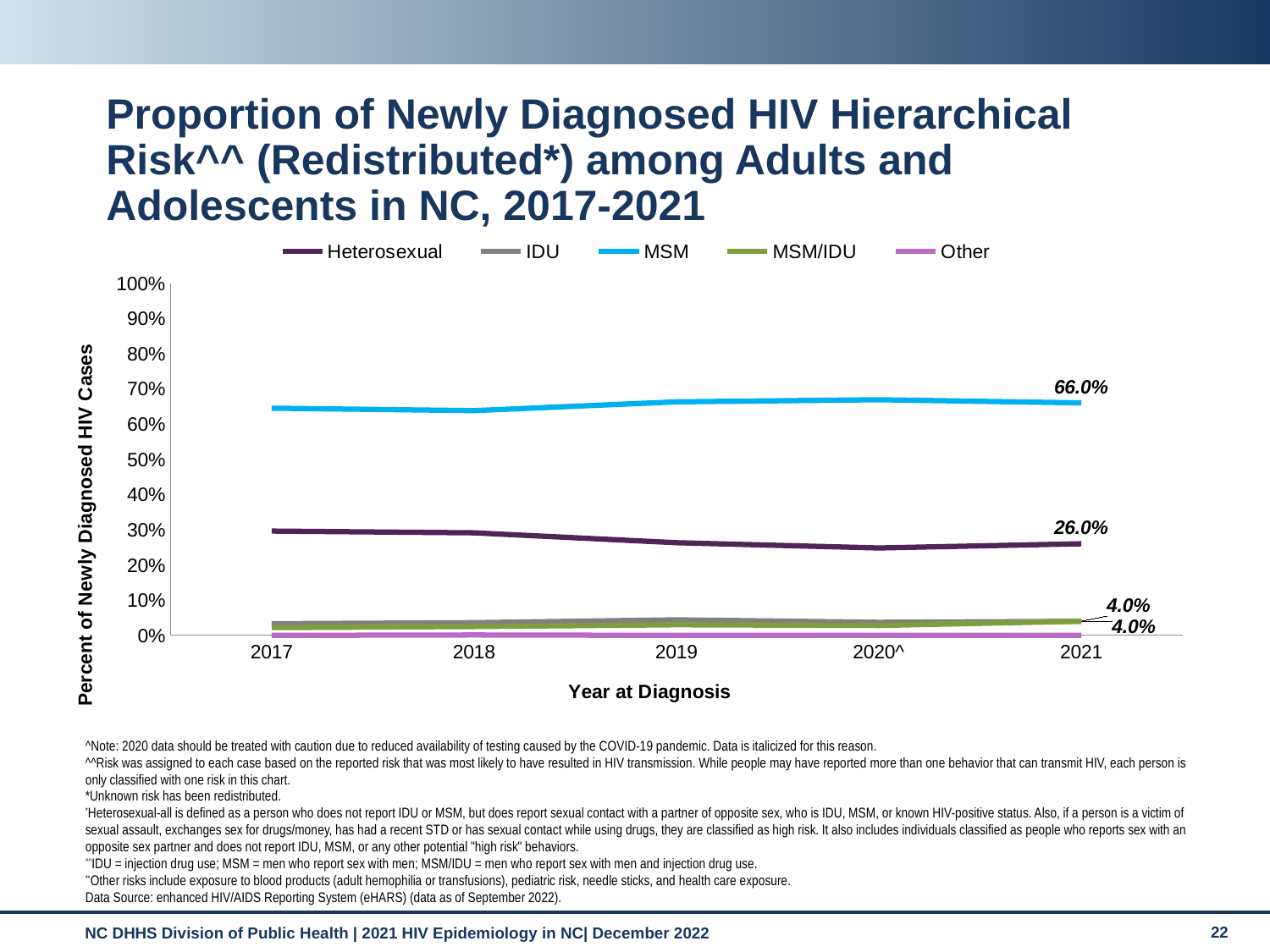
What is the value for MSM in 2021? 66.0% Is the value for Heterosexual in 2020^ greater or less than 30%? less Which risk category has the highest proportion in 2021? MSM Which risk category has the lowest line on the chart? Other Is the value for MSM in 2017 greater or less than 60%? greater In 2021, which is larger, the Heterosexual value or the MSM value? MSM How many series does the legend list? 5 What is the difference between the MSM and Heterosexual values in 2021? 40.0 percentage points What kind of chart is shown on the slide? Line chart What is the value for Heterosexual in 2021? 26.0% How many years are shown on the x axis? 5 What is the value for IDU in 2021? 4.0%